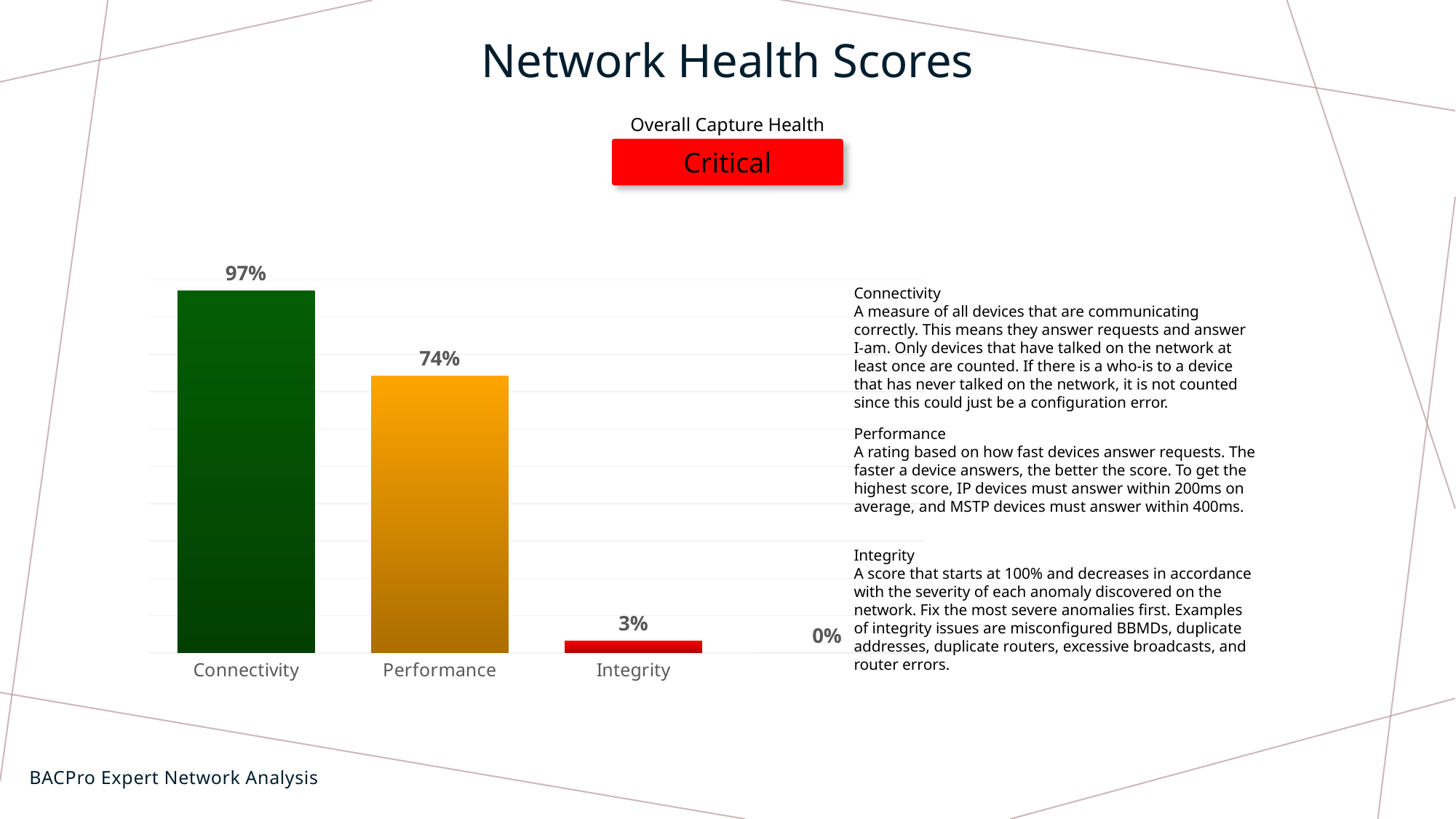
Do the values rise or fall from left to right across the categories? Fall Which is larger, the value for Performance or the value for Integrity? Performance What is the value for Connectivity? 97% What kind of chart is shown on the slide? Bar chart How many categories are shown in the chart? 3 What is the value for Performance? 74% What is the difference between the Performance and Integrity values? 71% What colour is the Integrity bar? Red Which category has the highest value? Connectivity What is the value for Integrity? 3% Which category has the lowest value? Integrity What is the difference between the Connectivity and Performance values? 23%